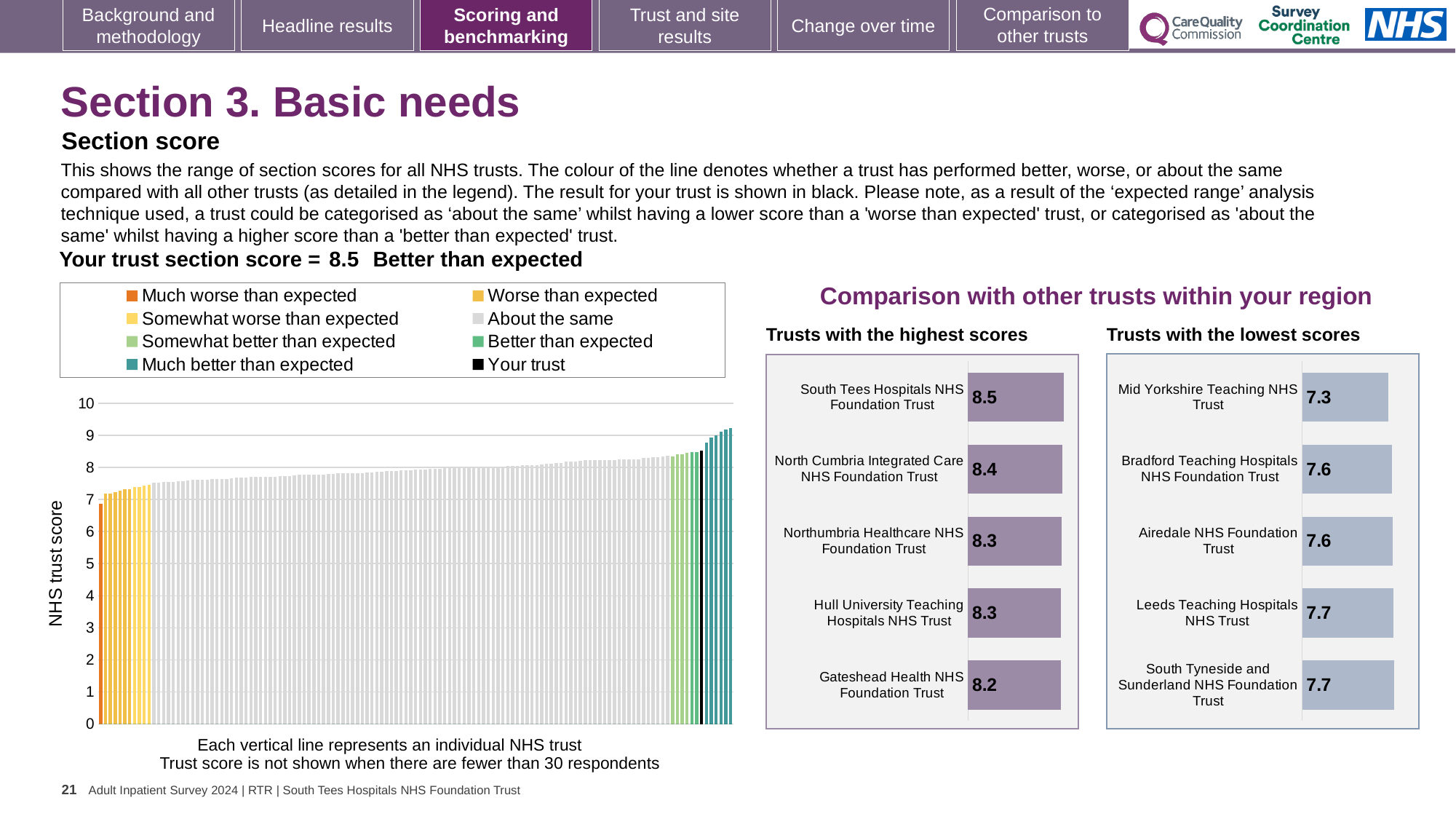
In the large chart on the left, is the value of the tallest bar greater or less than 9? greater In the 'Trusts with the lowest scores' chart, which has the larger score: Bradford Teaching Hospitals NHS Foundation Trust or Leeds Teaching Hospitals NHS Trust? Leeds Teaching Hospitals NHS Trust In the 'Trusts with the lowest scores' chart, what is the difference between the scores of Leeds Teaching Hospitals NHS Trust and Mid Yorkshire Teaching NHS Trust? 0.4 What type of chart is the large chart on the left showing NHS trust scores? Bar chart How many entries does the legend of the large chart on the left list? 8 In the large chart on the left, do the trust scores rise or fall from left to right? Rise How many trusts are shown in the 'Trusts with the highest scores' chart? 5 In the 'Trusts with the highest scores' chart, which trust has the highest score? South Tees Hospitals NHS Foundation Trust In the 'Trusts with the highest scores' chart, what is the difference between the scores of South Tees Hospitals NHS Foundation Trust and Gateshead Health NHS Foundation Trust? 0.3 In the 'Trusts with the lowest scores' chart, what is the score for Mid Yorkshire Teaching NHS Trust? 7.3 In the 'Trusts with the highest scores' chart, what is the score for North Cumbria Integrated Care NHS Foundation Trust? 8.4 In the 'Trusts with the lowest scores' chart, which trust has the lowest score? Mid Yorkshire Teaching NHS Trust